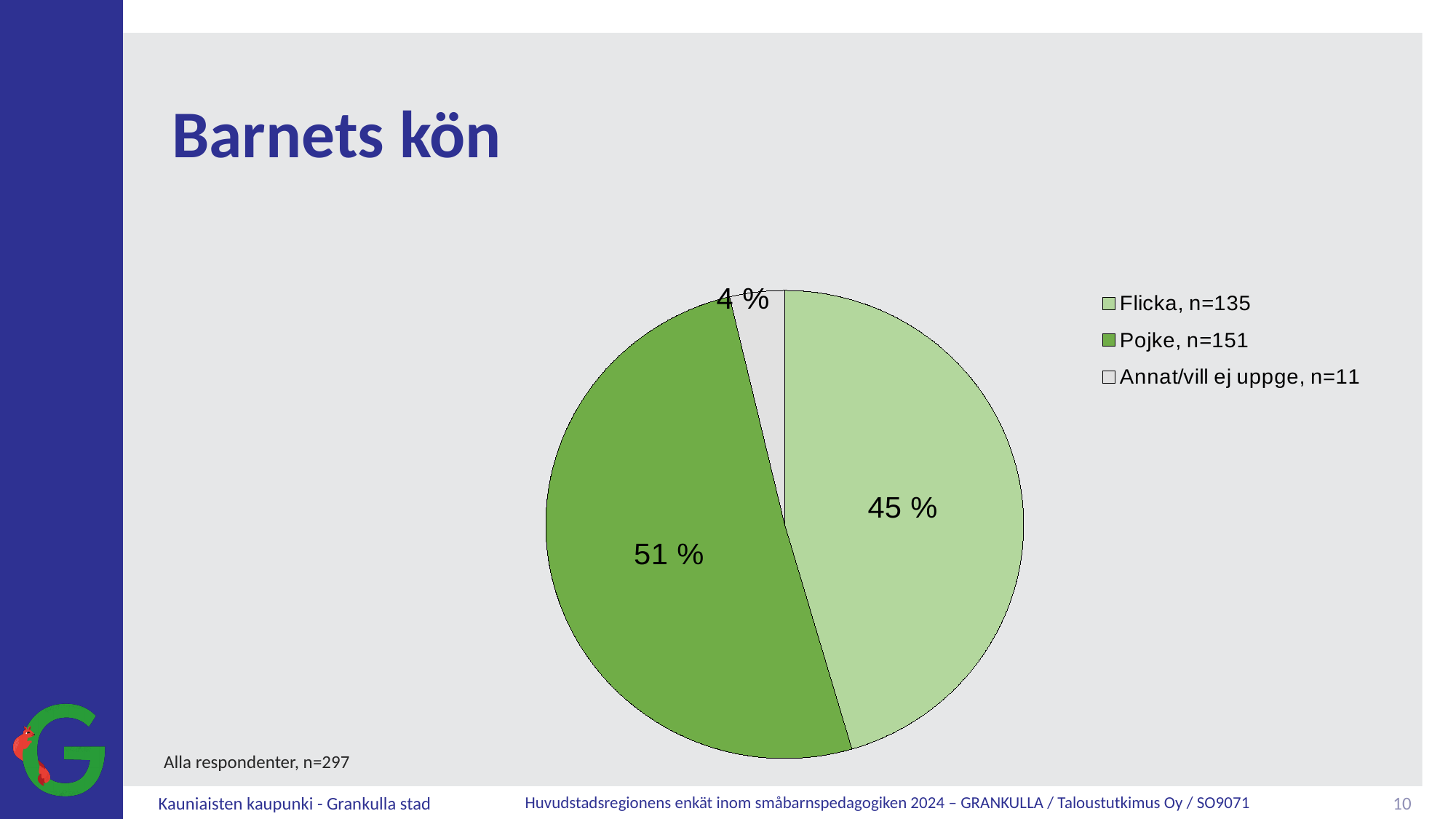
Which category has the largest slice of the pie? Pojke What share of the pie does Annat/vill ej uppge account for? 4 % What share of the pie does Flicka account for? 45 % According to the legend, how many respondents are in the Pojke category? n=151 What share of the pie does Pojke account for? 51 % What kind of chart is shown on the slide? pie chart Which slice is larger, Flicka or Pojke? Pojke Which category has the smallest slice of the pie? Annat/vill ej uppge What is the title of the slide containing the pie chart? Barnets kön According to the legend, how many respondents are in the Flicka category? n=135 What is the difference in percentage points between the Pojke and Flicka slices? 6 % How many slices does the pie chart have? 3